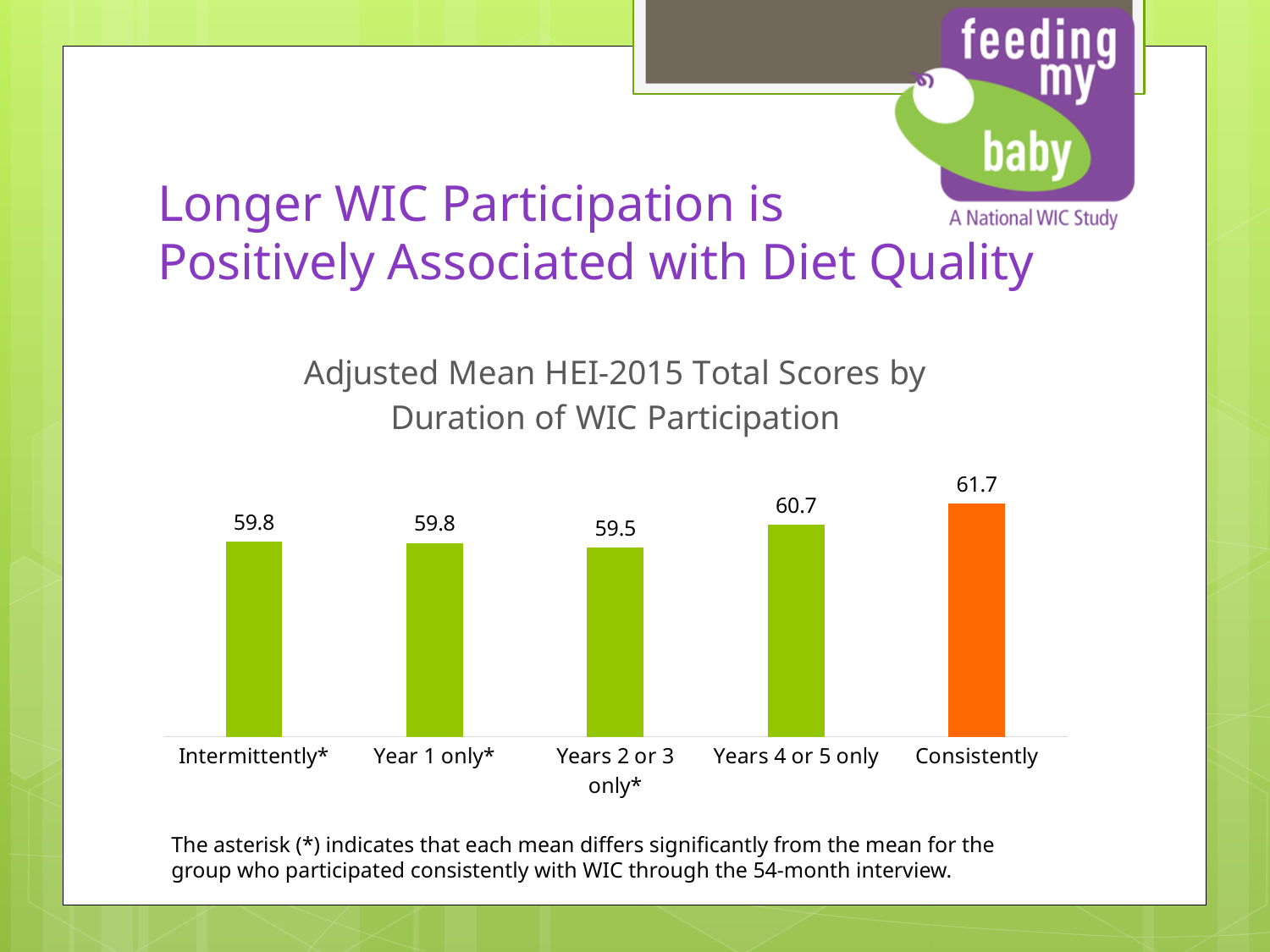
What is the adjusted mean HEI-2015 total score for the Consistently group? 61.7 Which bar in the chart is coloured orange rather than green? Consistently Which has a higher score, Year 1 only or Years 4 or 5 only? Years 4 or 5 only What is the difference between the scores for the Consistently group and the Years 2 or 3 only group? 2.2 What is the difference between the scores for the Consistently group and the Years 4 or 5 only group? 1.0 What is the adjusted mean HEI-2015 total score for the Years 2 or 3 only group? 59.5 What kind of chart is shown on the slide? Bar chart How many participation duration groups are shown in the chart? 5 Which group has the lowest adjusted mean HEI-2015 total score? Years 2 or 3 only Which group has the highest adjusted mean HEI-2015 total score? Consistently What is the adjusted mean HEI-2015 total score for the Intermittently group? 59.8 What is the adjusted mean HEI-2015 total score for the Years 4 or 5 only group? 60.7